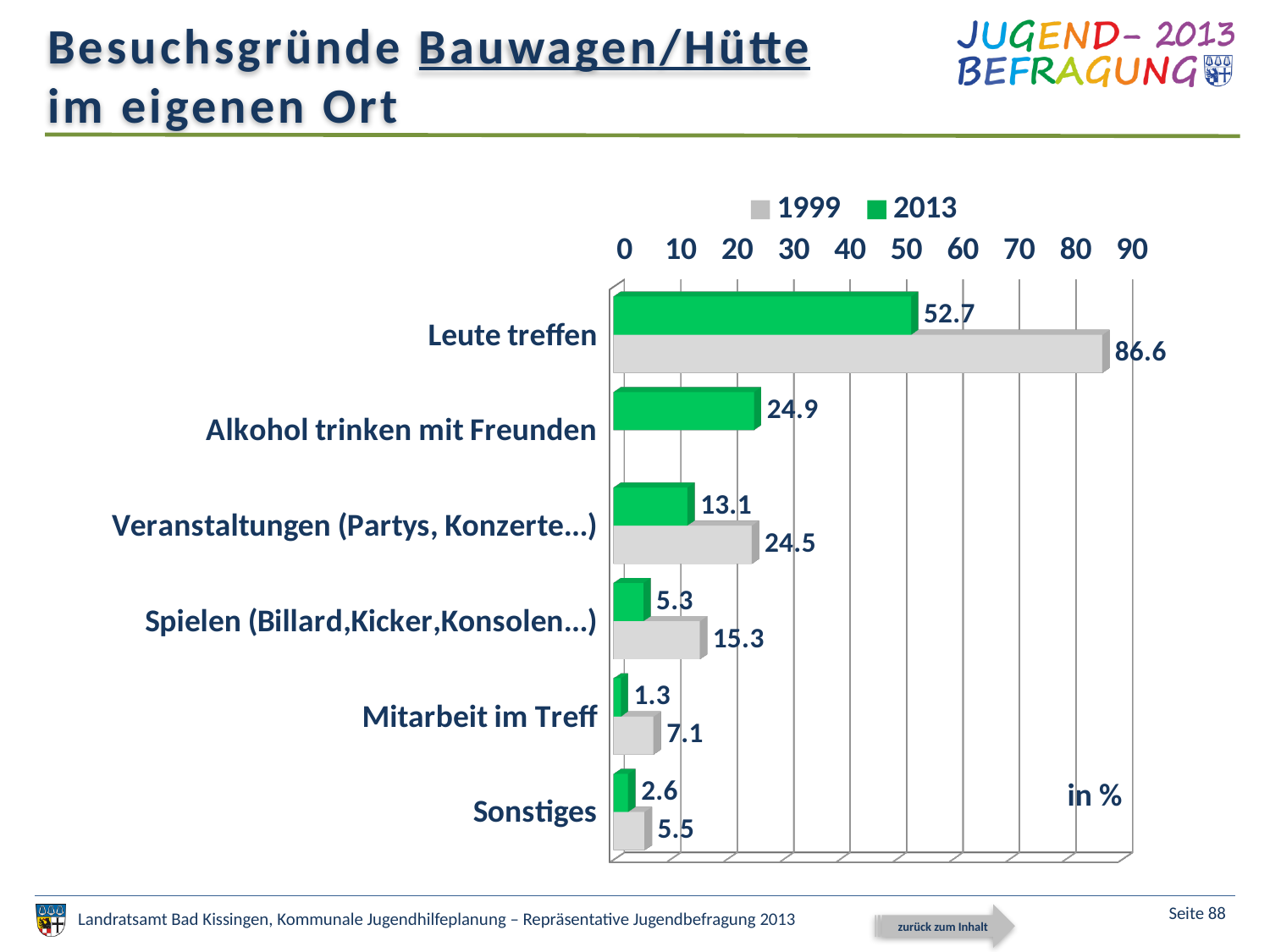
Which is larger for "Veranstaltungen (Partys, Konzerte...)": the 1999 value or the 2013 value? 1999 What kind of chart is shown on the slide? Bar chart Which category has the highest 2013 value? Leute treffen How many series does the legend list? 2 What is the difference between the 1999 and 2013 values for "Leute treffen"? 33.9 How many categories are shown on the chart? 6 What is the 1999 value for "Leute treffen"? 86.6 What is the 2013 value for "Mitarbeit im Treff"? 1.3 What is the 1999 value for "Spielen (Billard,Kicker,Konsolen...)"? 15.3 What is the 2013 value for "Alkohol trinken mit Freunden"? 24.9 Which category has the lowest 2013 value? Mitarbeit im Treff What is the 2013 value for "Leute treffen"? 52.7